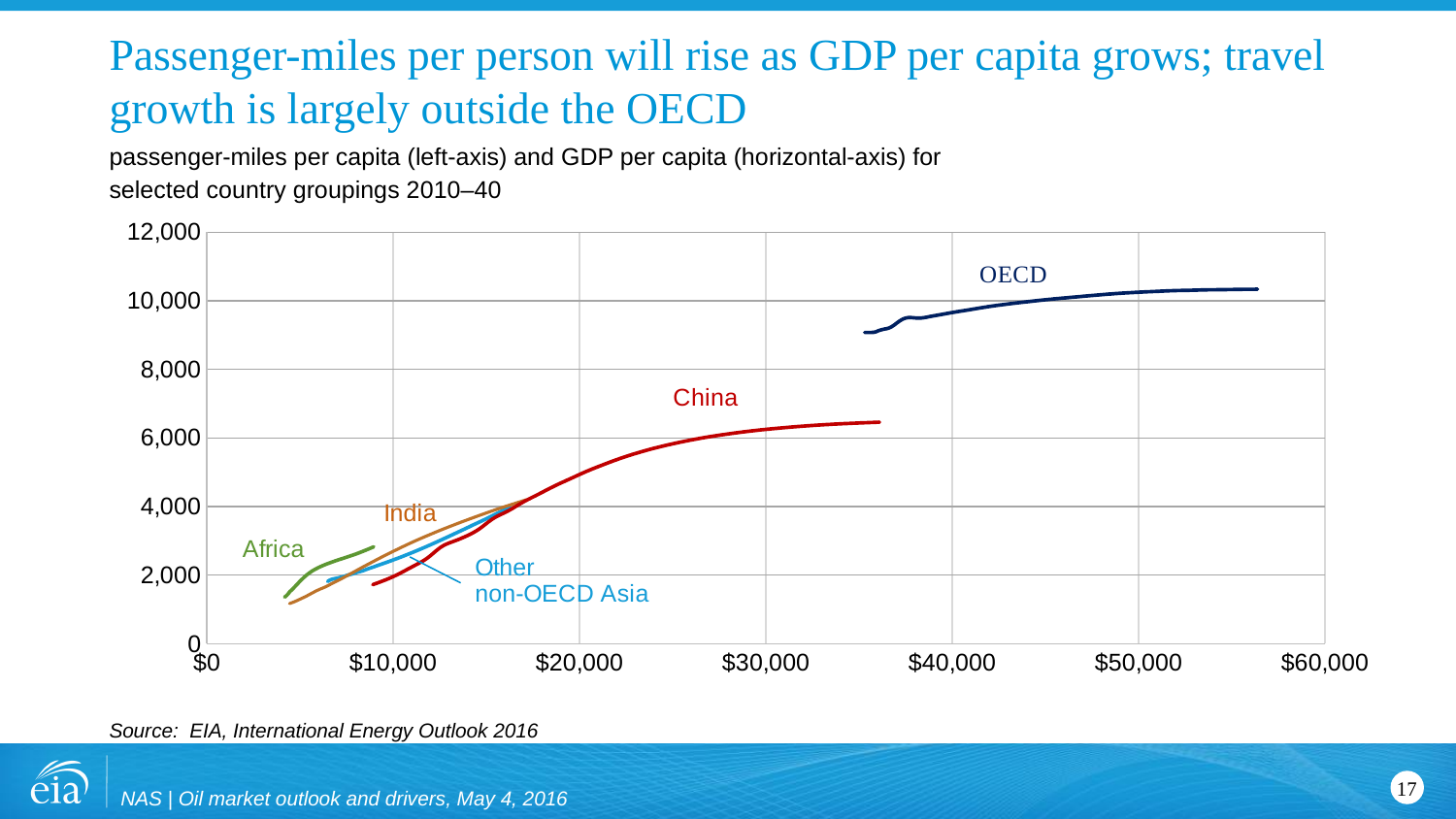
What source is cited for the chart? EIA, International Energy Outlook 2016 Which country grouping reaches the highest passenger-miles per capita? OECD Is the highest passenger-miles per capita value for OECD greater or less than 10,000? greater How many country groupings are plotted on the chart? 5 What is the maximum value shown on the vertical axis? 12,000 Do passenger-miles per capita rise or fall as GDP per capita grows for China? rise Does the China line end at a GDP per capita greater or less than $40,000? less Is the highest passenger-miles per capita value for Africa greater or less than 4,000? less What kind of chart is shown on the slide? line chart Which has higher passenger-miles per capita, OECD or China? OECD Which country grouping's line extends to the highest GDP per capita on the horizontal axis? OECD